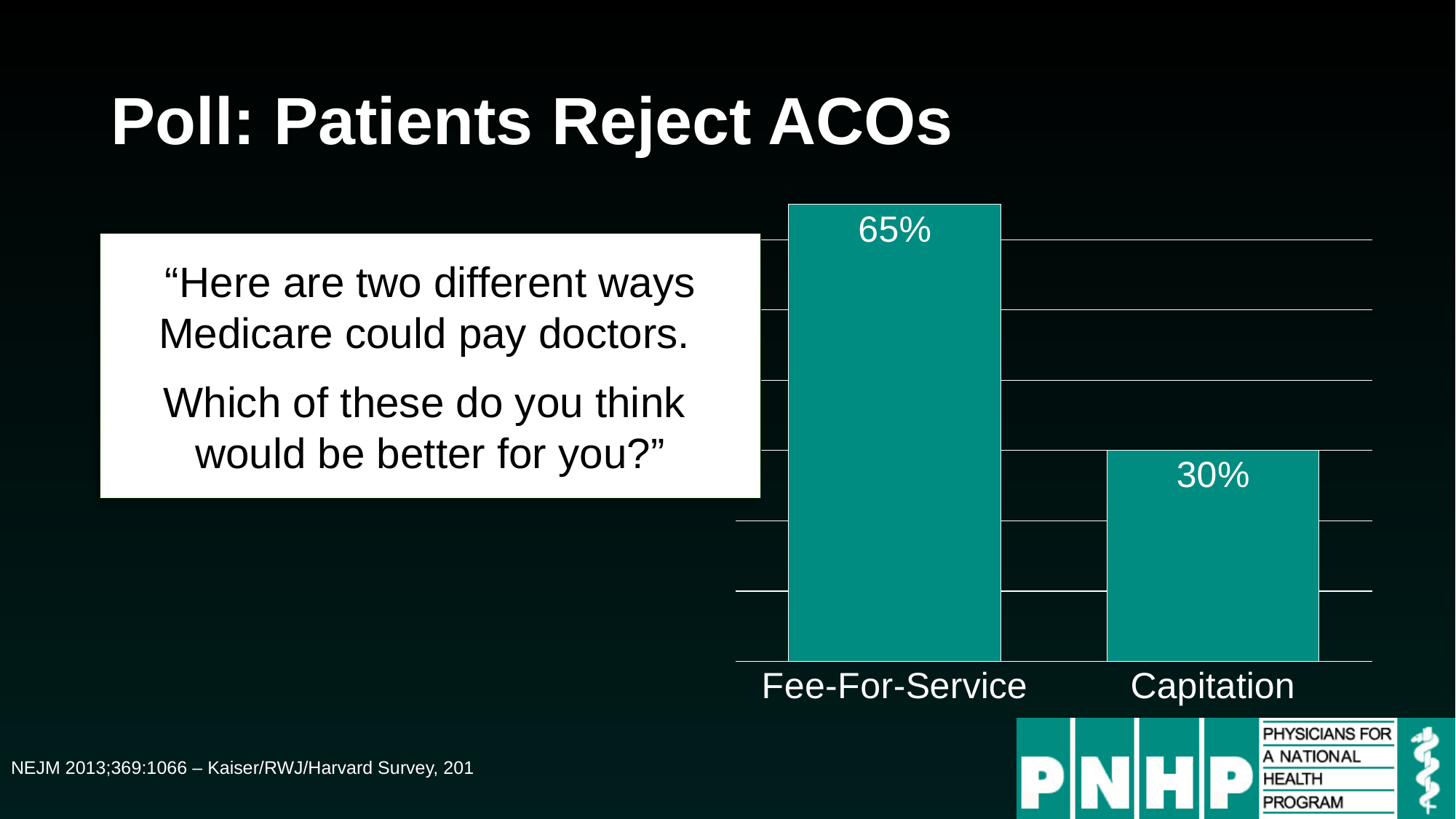
Which is larger, the value for Fee-For-Service or the value for Capitation? Fee-For-Service What colour are the bars in the chart? Teal What kind of chart is shown on the slide? Bar chart What is the title of the slide containing the chart? Poll: Patients Reject ACOs How many categories are shown in the chart? 2 Which category has the highest value? Fee-For-Service Which category has the lowest value? Capitation What percentage of respondents chose Capitation? 30% What percentage of respondents chose Fee-For-Service? 65% What is the difference between the Fee-For-Service and Capitation values? 35%